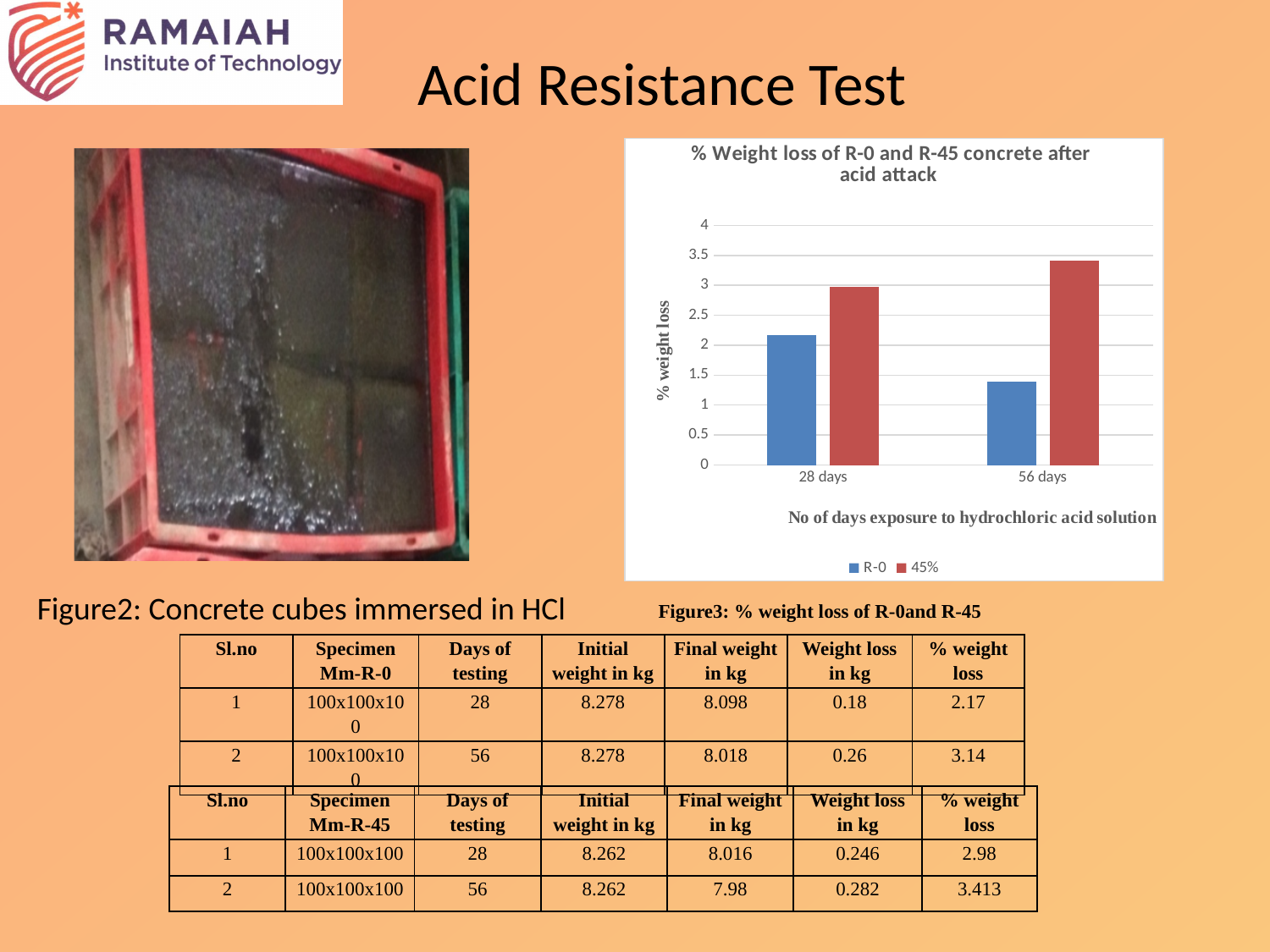
How many categories are shown on the x axis of the chart? 2 How many series does the chart legend list? 2 What is the title of the chart? % Weight loss of R-0 and R-45 concrete after acid attack Is the value for 45% at 28 days greater or less than 2.5? greater What is the label of the chart's x axis? No of days exposure to hydrochloric acid solution Is the value for R-0 at 28 days greater or less than 2? greater Is the value for R-0 at 56 days greater or less than 2? less Which bar in the chart is the lowest? R-0 at 56 days What kind of chart is shown on the slide? bar chart Which series has the higher value at 56 days, R-0 or 45%? 45%